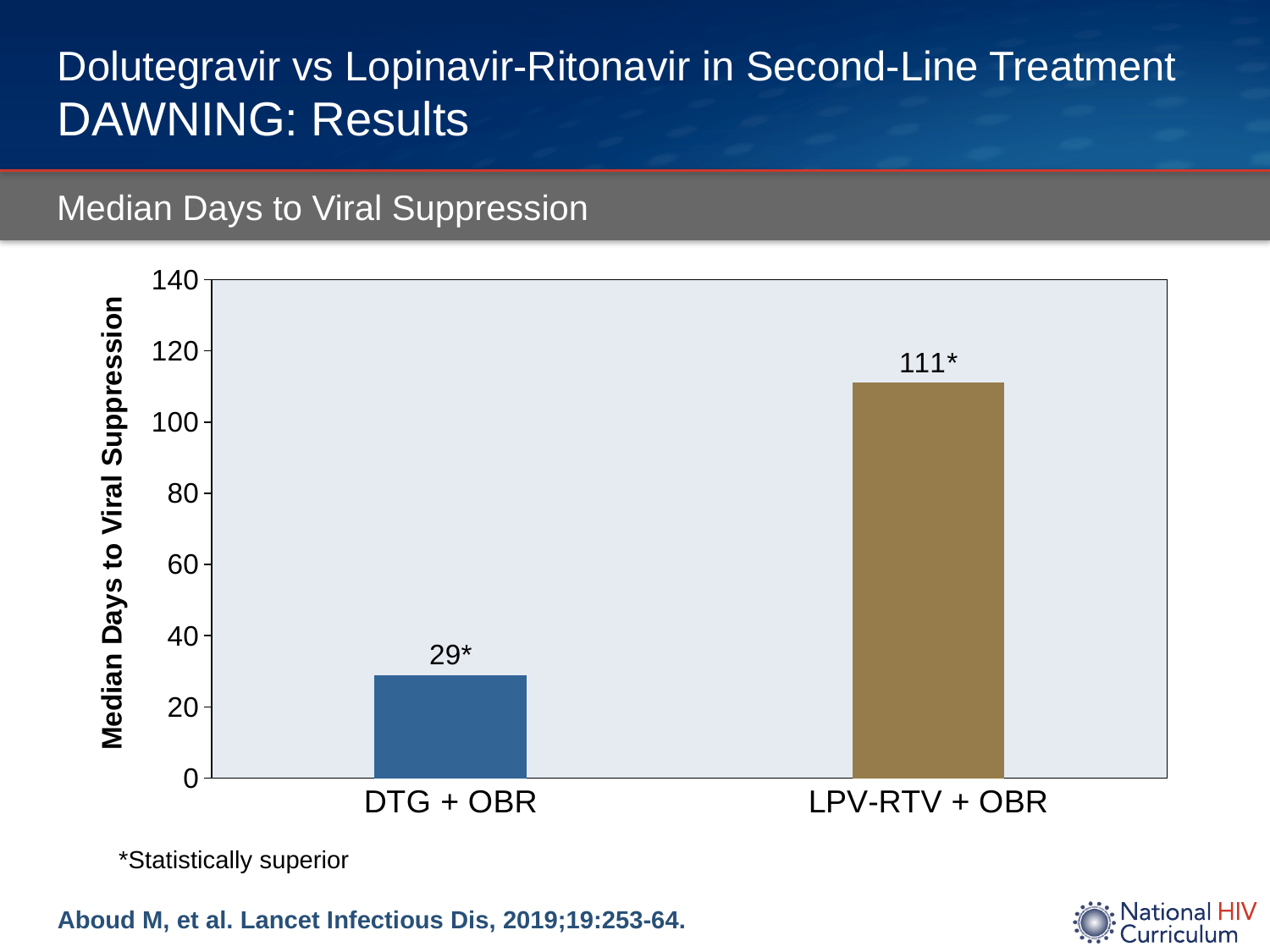
Which treatment group has the lower median days to viral suppression? DTG + OBR Which treatment group has the higher median days to viral suppression? LPV-RTV + OBR How many treatment groups are shown in the chart? 2 Is the value for DTG + OBR greater or less than 40? less What does the asterisk next to the data labels indicate? Statistically superior Is the median days to viral suppression larger for DTG + OBR or LPV-RTV + OBR? LPV-RTV + OBR What is the difference in median days to viral suppression between LPV-RTV + OBR and DTG + OBR? 82 What is the median days to viral suppression for DTG + OBR? 29* What is the median days to viral suppression for LPV-RTV + OBR? 111* What kind of chart is shown on the slide? Bar chart Is the value for LPV-RTV + OBR greater or less than 100? greater What is the label of the y-axis? Median Days to Viral Suppression